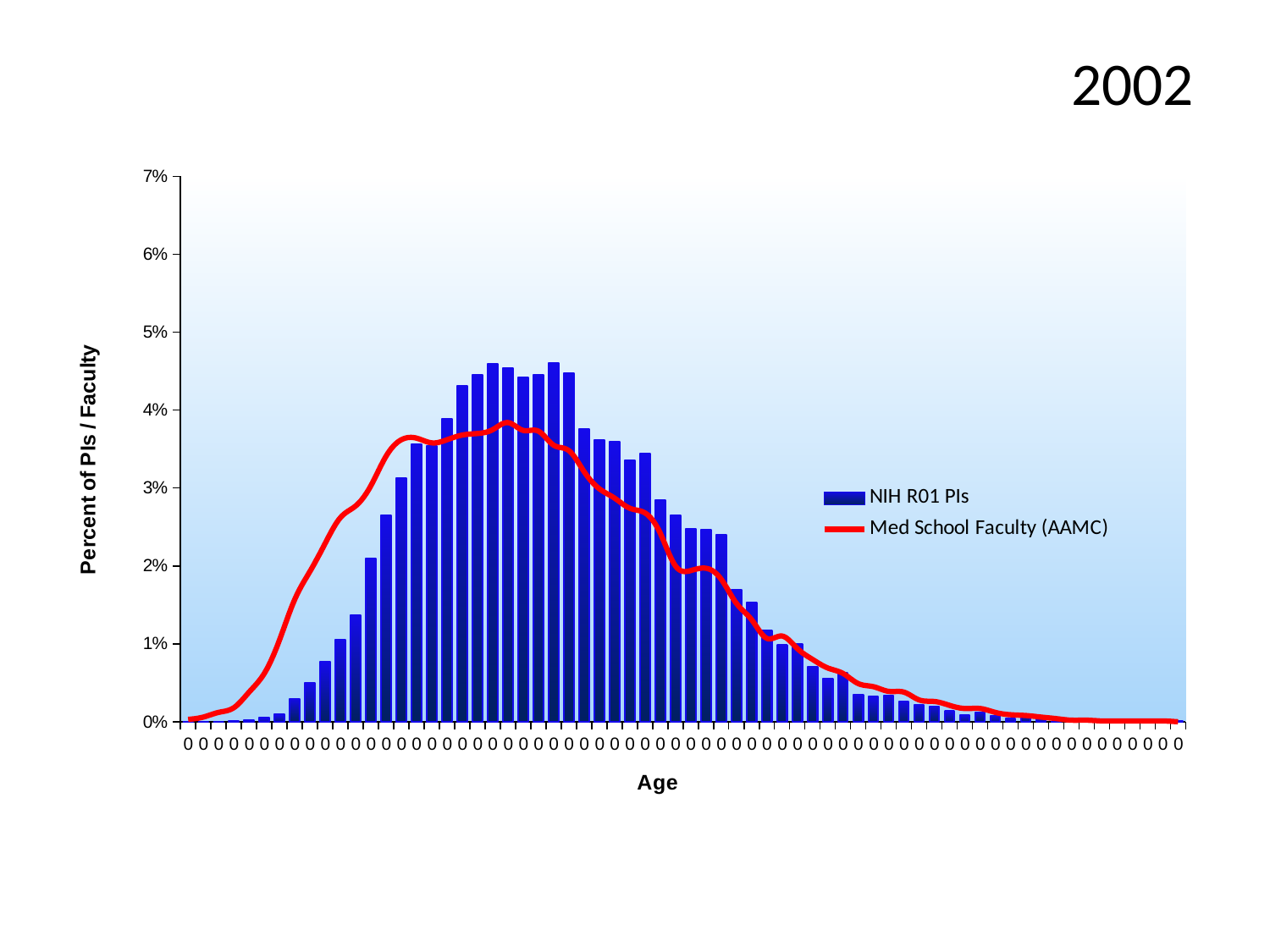
Is the highest value for Med School Faculty (AAMC) greater or less than 4%? less What kind of chart is shown on the slide? A bar chart with a line overlay What is the title of the y axis? Percent of PIs / Faculty Which series reaches a higher peak value, NIH R01 PIs or Med School Faculty (AAMC)? NIH R01 PIs Is the highest value for NIH R01 PIs greater or less than 4%? greater Is the highest value for NIH R01 PIs greater or less than 5%? less Do the NIH R01 PIs values rise or fall toward the right end of the x axis? fall Which series is drawn as a red line? Med School Faculty (AAMC) How many series does the legend list? 2 Do the Med School Faculty (AAMC) values rise or fall at the left end of the x axis? rise